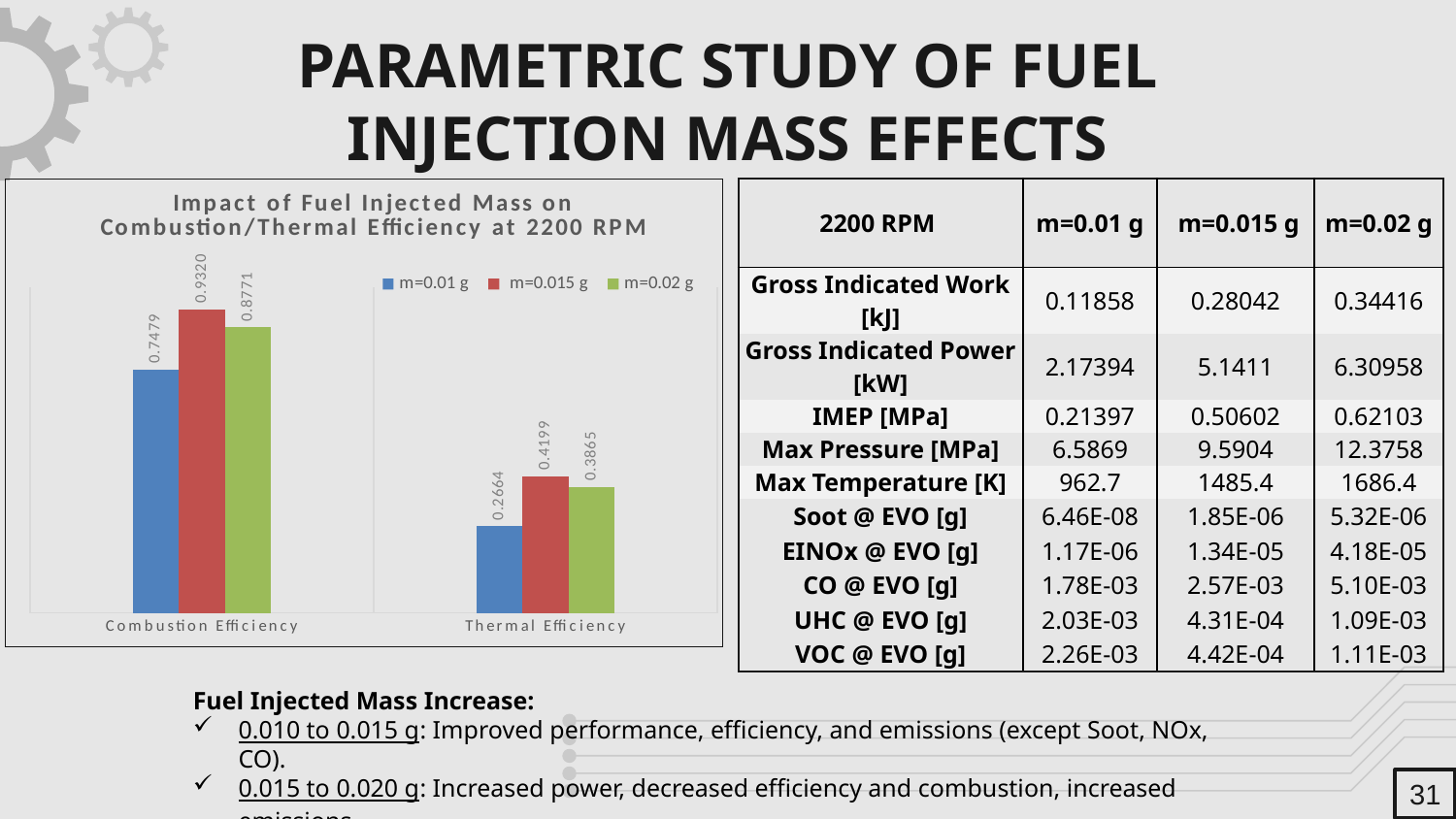
What is the combustion efficiency for m=0.015 g? 0.9320 What is the thermal efficiency for m=0.02 g? 0.3865 What is the difference between the combustion efficiency at m=0.015 g and at m=0.01 g? 0.1841 What type of chart is shown on the slide? Bar chart Which fuel injected mass gives the highest combustion efficiency? m=0.015 g What is the combustion efficiency for m=0.01 g? 0.7479 How many categories are shown on the x axis of the chart? 2 Which fuel injected mass gives the lowest thermal efficiency? m=0.01 g What is the difference between the thermal efficiency at m=0.015 g and at m=0.02 g? 0.0334 Which is larger: the combustion efficiency at m=0.02 g or at m=0.01 g? m=0.02 g What is the thermal efficiency for m=0.01 g? 0.2664 How many series does the chart legend list? 3